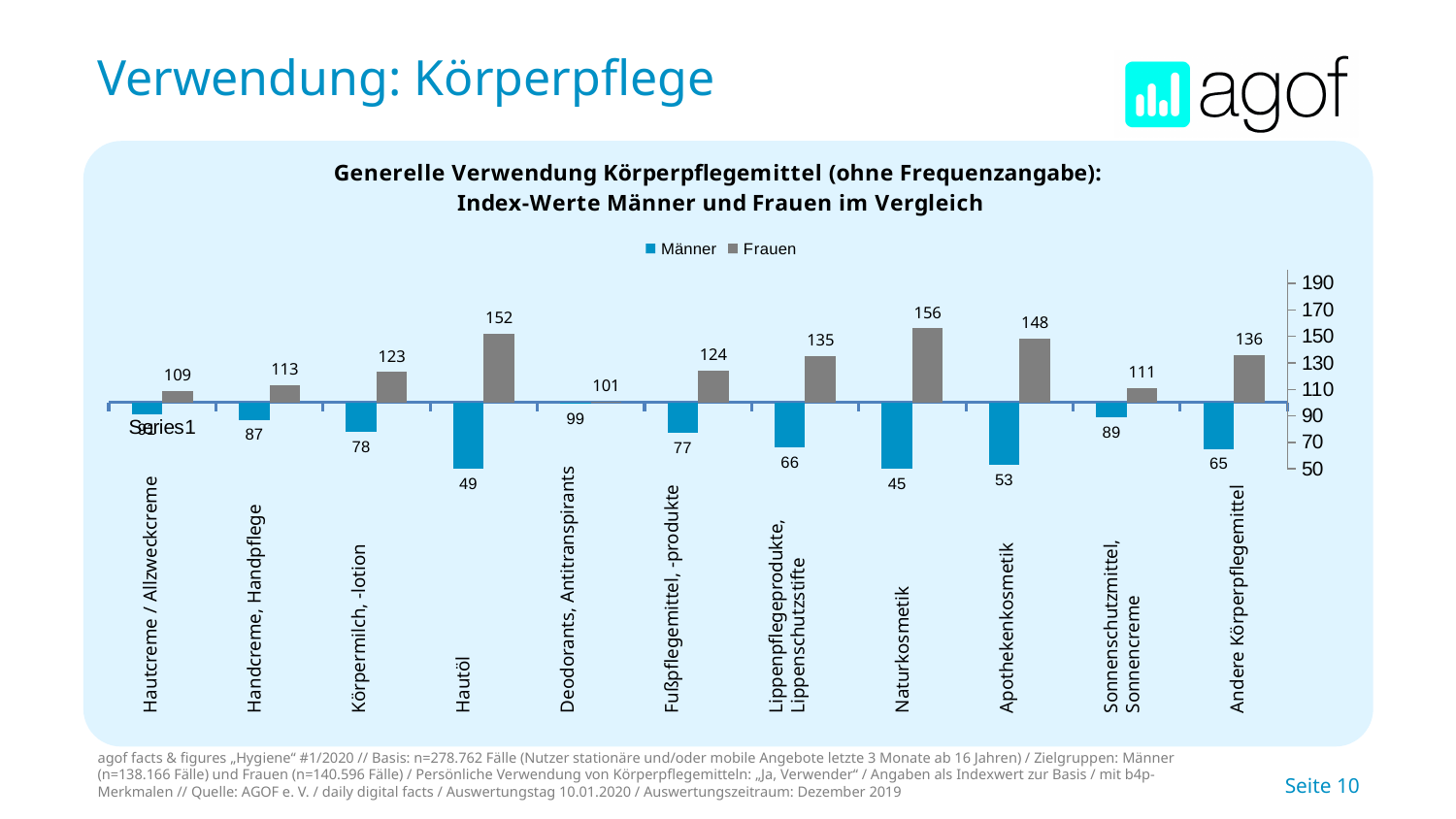
Which category has the lowest Männer index value? Naturkosmetik Which category has the highest Frauen index value? Naturkosmetik What is the difference between the Frauen and Männer index values for Apothekenkosmetik? 95 How many product categories are shown on the x axis? 11 How many series does the legend list? 2 What is the Frauen index value for Lippenpflegeprodukte, Lippenschutzstifte? 135 What kind of chart is shown on the slide? bar chart What is the Männer index value for Deodorants, Antitranspirants? 99 What is the Männer index value for Naturkosmetik? 45 Which is larger, the Männer value for Sonnenschutzmittel, Sonnencreme or the Männer value for Andere Körperpflegemittel? Sonnenschutzmittel, Sonnencreme What is the Frauen index value for Hautöl? 152 Which series is shown in grey in the legend? Frauen